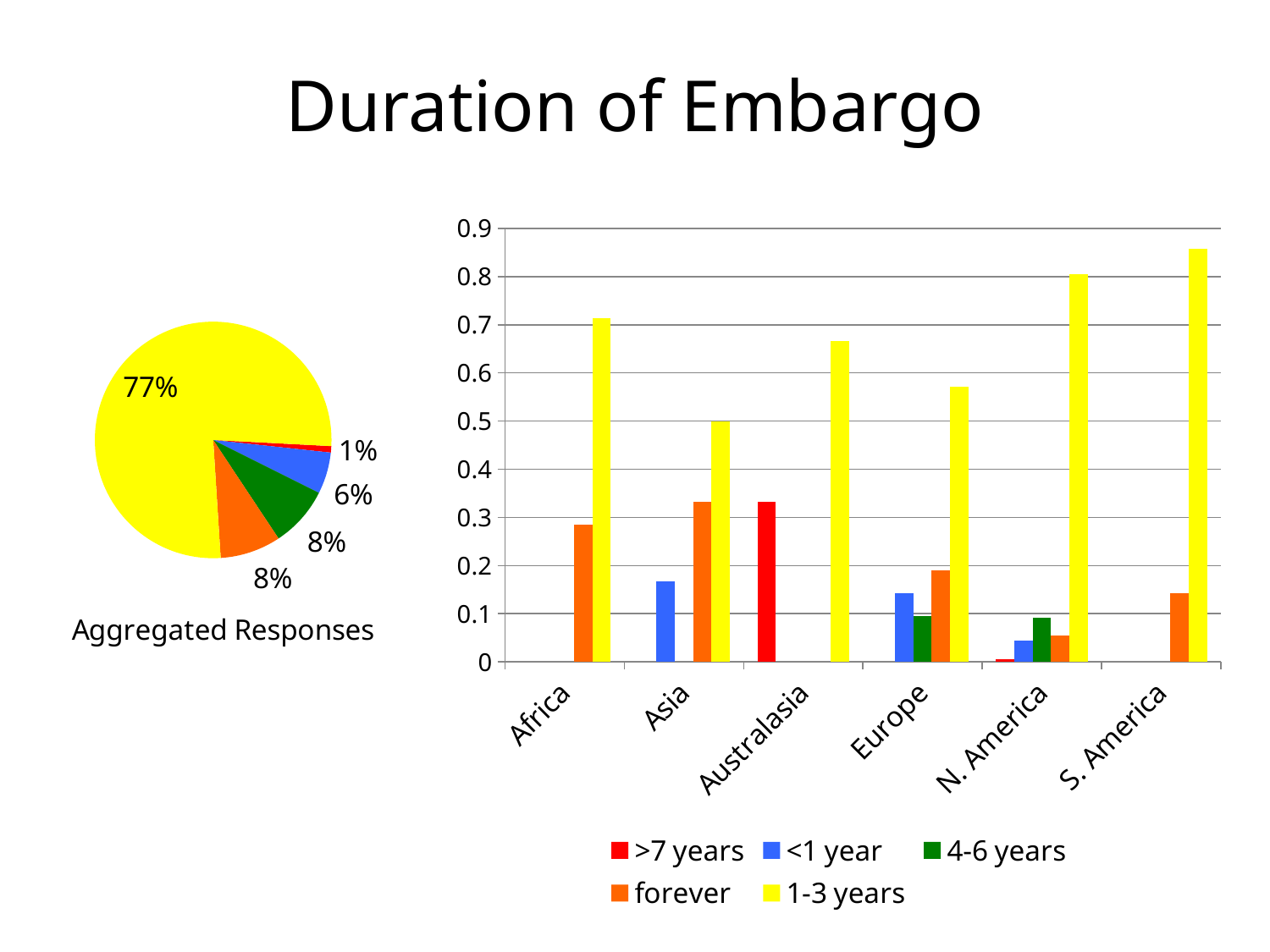
On the bar chart on the right, is the 1-3 years value for S. America greater or less than 0.8? greater On the bar chart on the right, how many series does the legend list? 5 On the pie chart titled Aggregated Responses, what is the value of the smallest slice? 1% On the bar chart on the right, is the forever value for Africa greater or less than 0.3? less What kind of chart is the chart on the right of the slide? bar chart On the bar chart on the right, is the >7 years value for Australasia greater or less than 0.3? greater On the pie chart titled Aggregated Responses, how many slices are there? 5 On the bar chart on the right, how many regions are shown on the x axis? 6 On the pie chart titled Aggregated Responses, what is the difference between the largest slice and the smallest slice? 76% On the pie chart titled Aggregated Responses, what is the value of the largest slice? 77% On the bar chart on the right, which region has the tallest 1-3 years bar? S. America On the bar chart on the right, for Asia, which is larger: the forever bar or the <1 year bar? forever